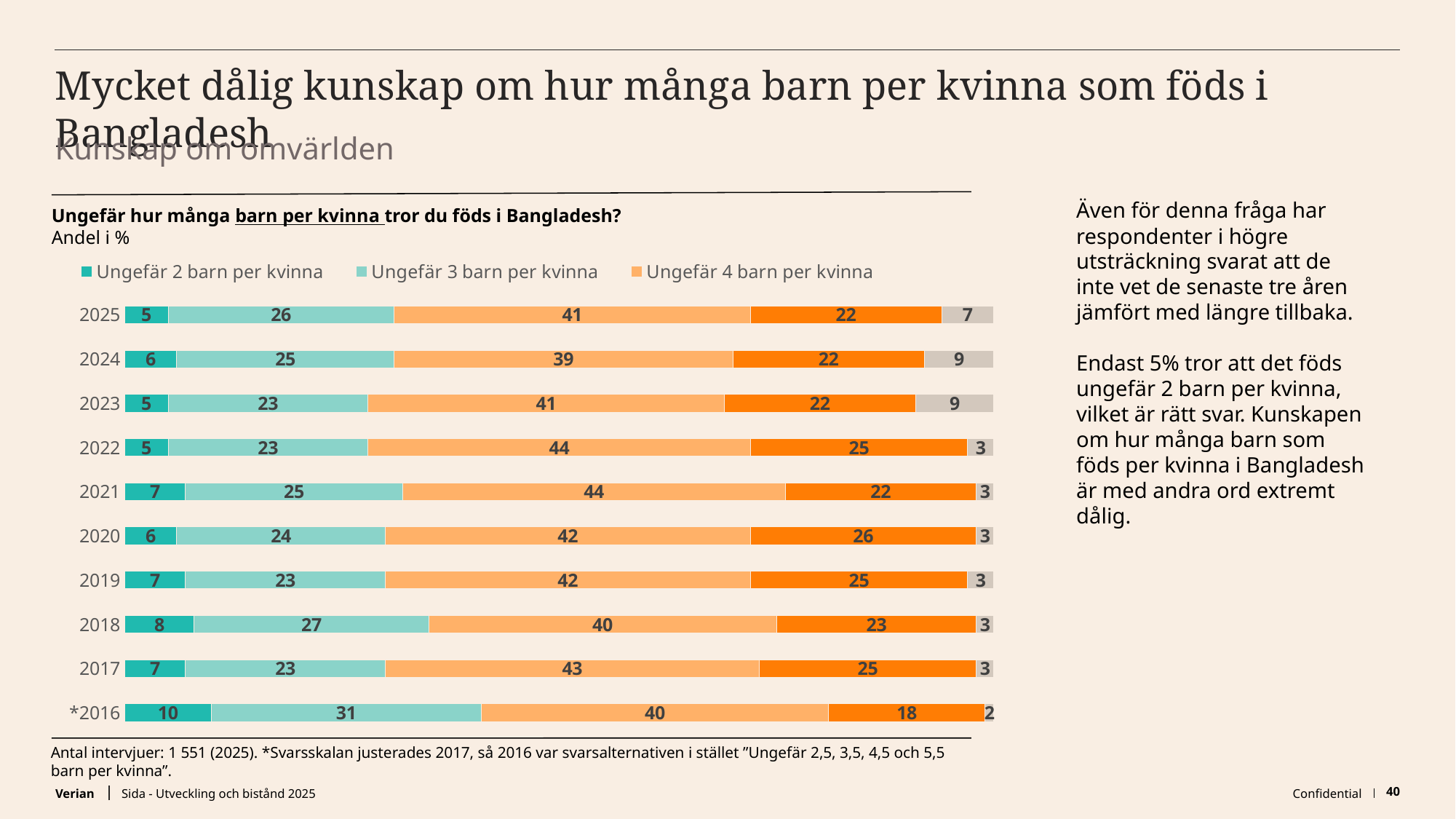
Which year has the larger value for "Ungefär 4 barn per kvinna", 2024 or 2017? 2017 What is the value for "Ungefär 2 barn per kvinna" in 2025? 5 In which year is the value for "Ungefär 2 barn per kvinna" highest? *2016 What question is the chart based on, as shown above the chart? Ungefär hur många barn per kvinna tror du föds i Bangladesh? How many years are shown on the chart? 10 In which year is the value for "Ungefär 4 barn per kvinna" lowest? 2024 Does the value for "Ungefär 2 barn per kvinna" generally rise or fall from *2016 to 2025? Fall What is the difference between the "Ungefär 2 barn per kvinna" values for 2018 and 2025? 3 What is the value for "Ungefär 4 barn per kvinna" in 2022? 44 How many series does the legend list? 3 What kind of chart is shown on the slide? Stacked bar chart What is the value for "Ungefär 3 barn per kvinna" in *2016? 31